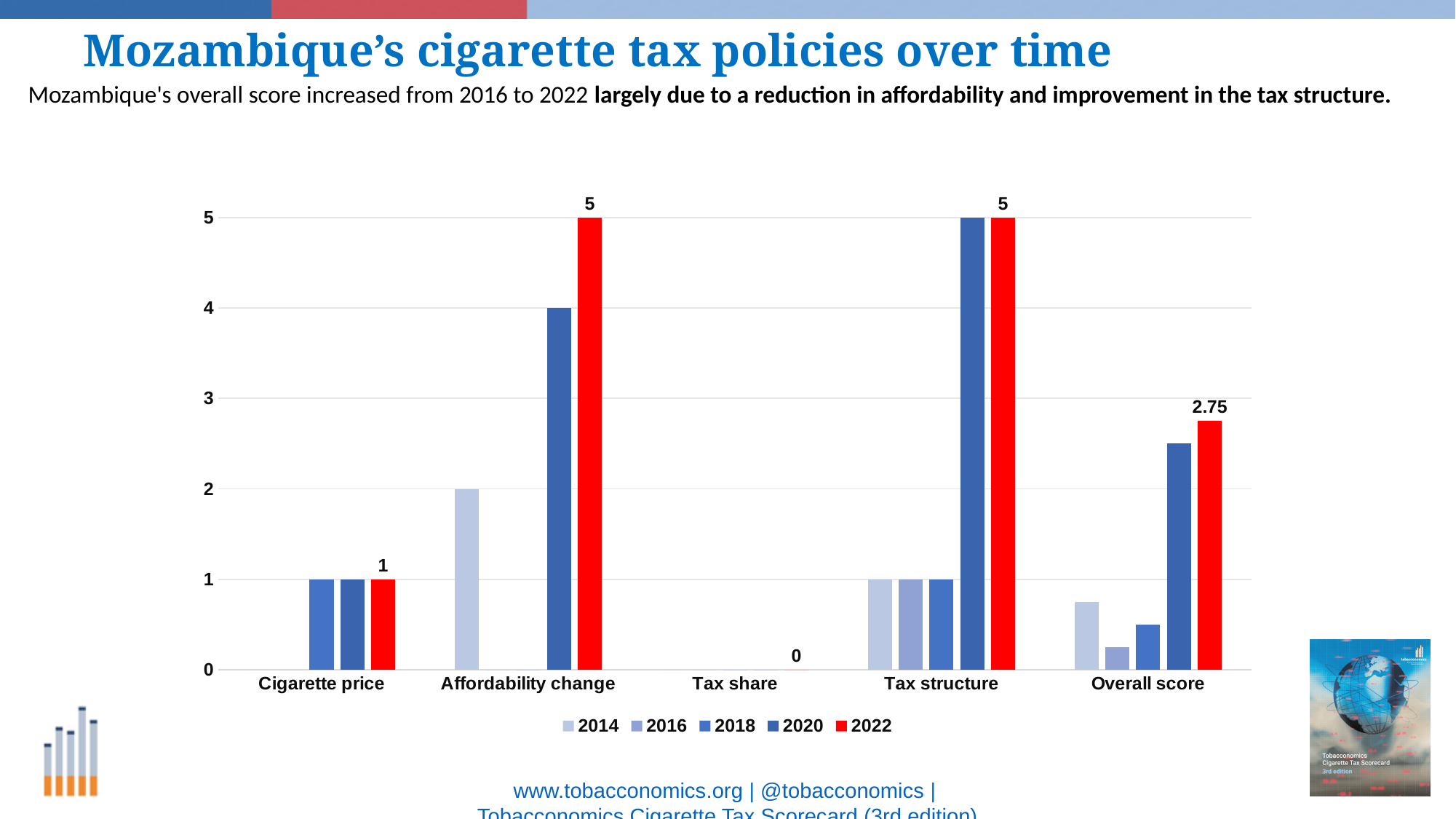
How many categories are shown on the x axis? 5 What is the value for Affordability change in 2020? 4 Which is larger in 2022: Overall score or Cigarette price? Overall score Is the value for Overall score in 2020 greater or less than 2? greater What is the value for Tax share in 2022? 0 What is the difference between the 2022 values for Affordability change and Overall score? 2.25 Is the value for Overall score in 2016 greater or less than 1? less Which category has the lowest value for 2022? Tax share What is the value for Affordability change in 2022? 5 What is the value for Overall score in 2022? 2.75 What kind of chart is shown on the slide? bar chart How many series does the legend list? 5